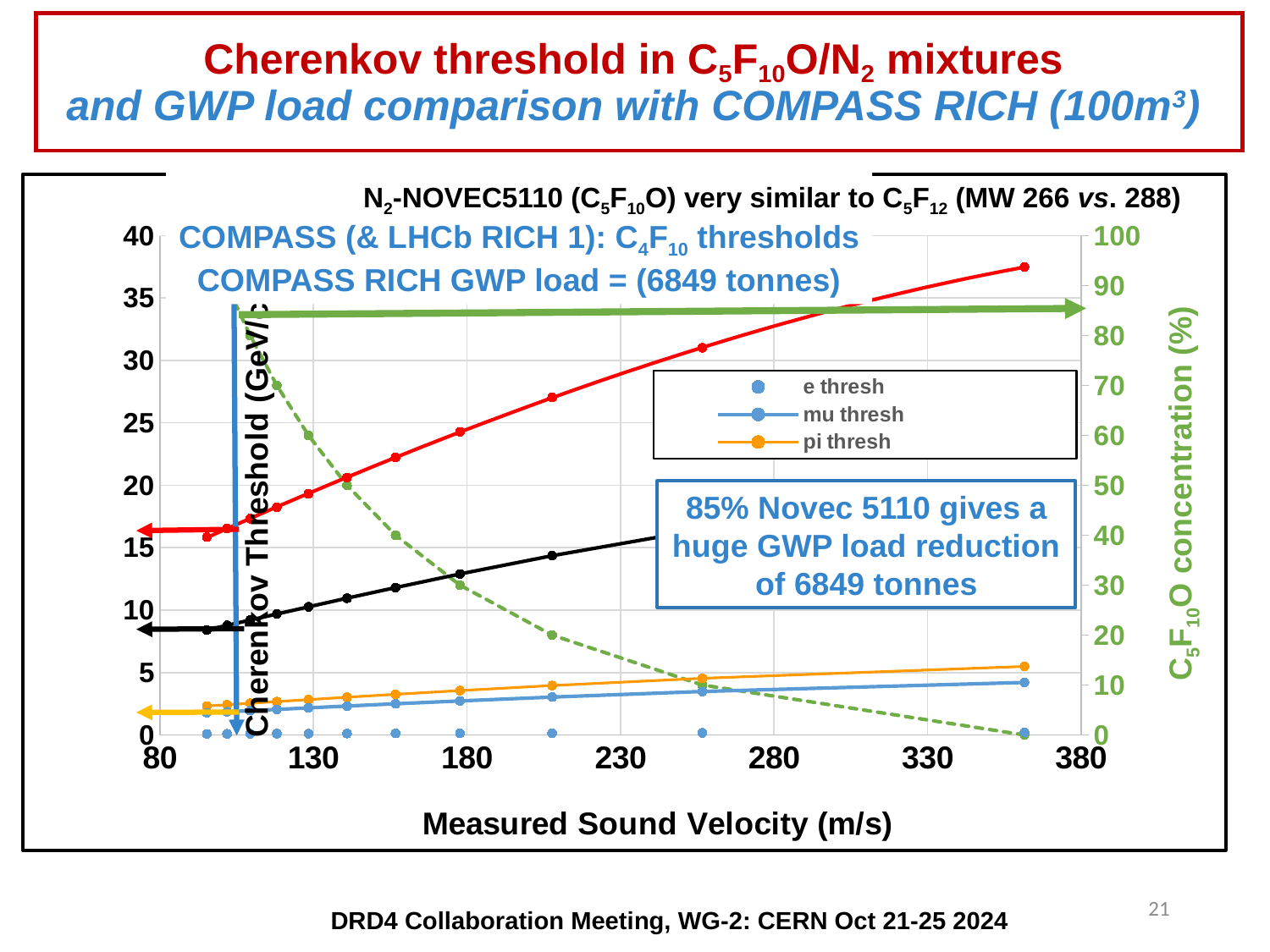
Is the value of the black line at about 210 m/s greater or less than 15? less Is the e thresh value at about 180 m/s greater or less than 5? less Is the green dashed line at about 130 m/s greater or less than 50 on the right-hand axis? greater How many series does the legend list? 3 At about 360 m/s, which is higher, pi thresh or mu thresh? pi thresh At about 180 m/s, which is higher, the red line or the black line? the red line Does the red line rise or fall as the measured sound velocity increases? rise What is the title of the x axis? Measured Sound Velocity (m/s) What kind of chart is shown on the slide? line chart Does the green dashed line rise or fall as the measured sound velocity increases? fall What is the title of the right-hand y axis? C5F10O concentration (%)